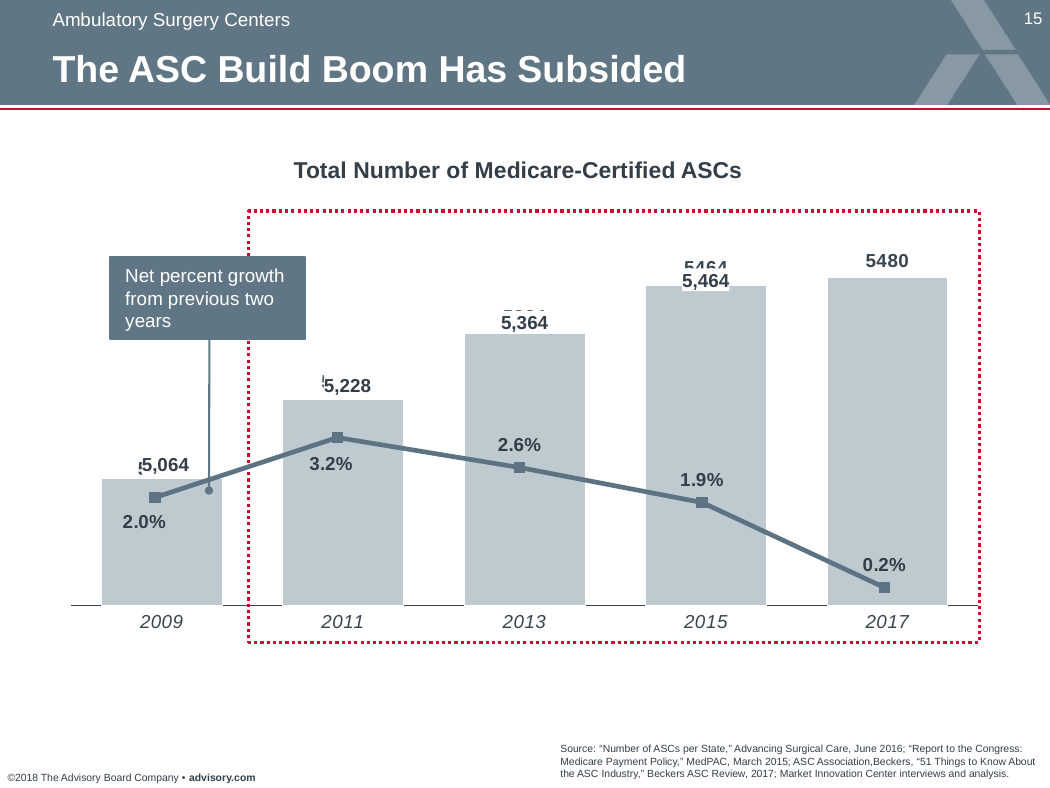
How many years are shown on the x axis of the chart? 5 What is the total number of Medicare-certified ASCs shown for 2017? 5480 Does the net percent growth line rise or fall from 2011 to 2017? fall Which year has more Medicare-certified ASCs, 2009 or 2015? 2015 What is the total number of Medicare-certified ASCs shown for 2009? 5,064 What is the total number of Medicare-certified ASCs shown for 2013? 5,364 Which year has the lowest net percent growth from the previous two years? 2017 What net percent growth from the previous two years is shown for 2017? 0.2% What net percent growth from the previous two years is shown for 2011? 3.2% What is the title of the chart? Total Number of Medicare-Certified ASCs What is the difference between the number of ASCs in 2013 and in 2011? 136 Which year has the highest net percent growth from the previous two years? 2011